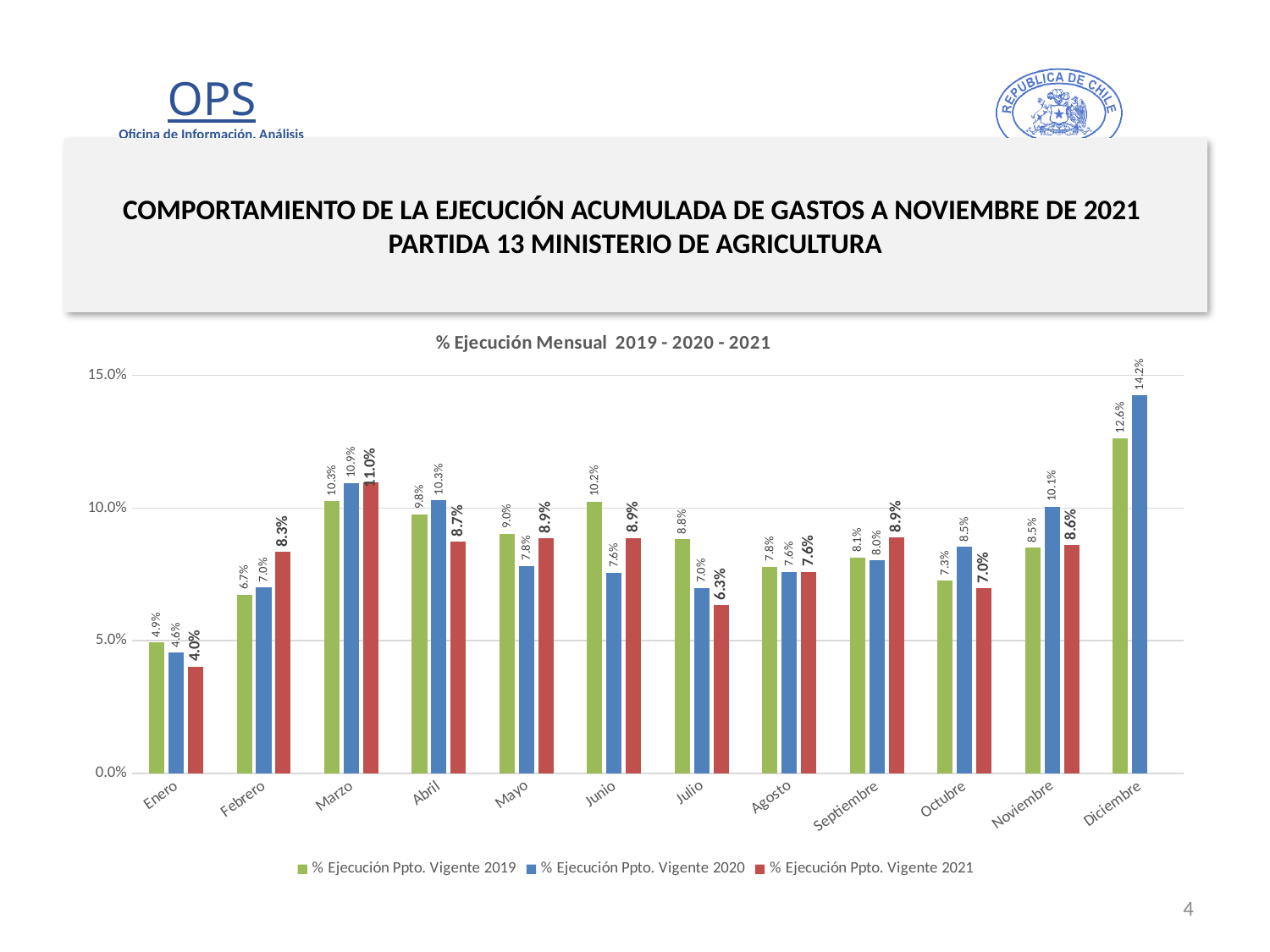
What is the value for Noviembre in the % Ejecución Ppto. Vigente 2020 series? 10.1% Which is larger for Julio: the 2019 value or the 2021 value? 2019 value Which month has the highest value in the % Ejecución Ppto. Vigente 2020 series? Diciembre How many series does the legend list? 3 What kind of chart is shown on the slide? Bar chart What is the value for Marzo in the % Ejecución Ppto. Vigente 2021 series? 11.0% Is the value for Abril in the 2020 series greater or less than 10.0%? greater How many months are shown on the x axis? 12 What is the difference between the 2020 and 2019 values for Diciembre? 1.6% Which month has the lowest value in the % Ejecución Ppto. Vigente 2021 series? Enero What is the title of the chart? % Ejecución Mensual 2019 - 2020 - 2021 What is the value for Junio in the % Ejecución Ppto. Vigente 2019 series? 10.2%